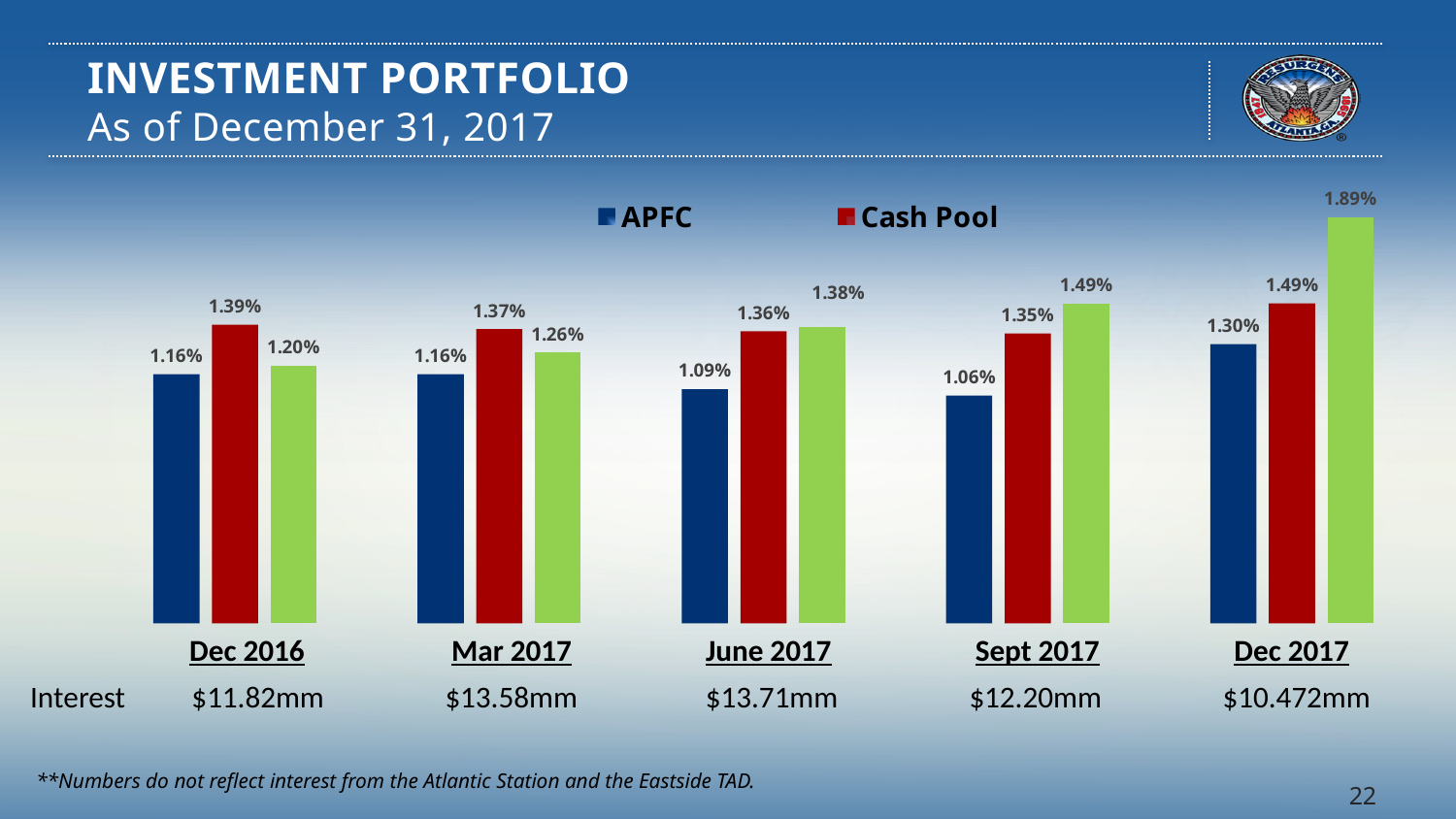
Which is larger, the Cash Pool value for Mar 2017 or for June 2017? Mar 2017 What is the Cash Pool value for Dec 2017? 1.49% What is the APFC value for June 2017? 1.09% In which period is the Cash Pool value lowest? Sept 2017 Does the APFC value rise or fall from Dec 2016 to Sept 2017? Fall In which period is the APFC value highest? Dec 2017 What kind of chart is shown on the slide? Bar chart What is the difference between the Cash Pool and APFC values for Dec 2017? 0.19% What is the APFC value for Dec 2016? 1.16% How many time periods are shown on the x axis? 5 How many series does the legend list? 2 In which period is the APFC value lowest? Sept 2017